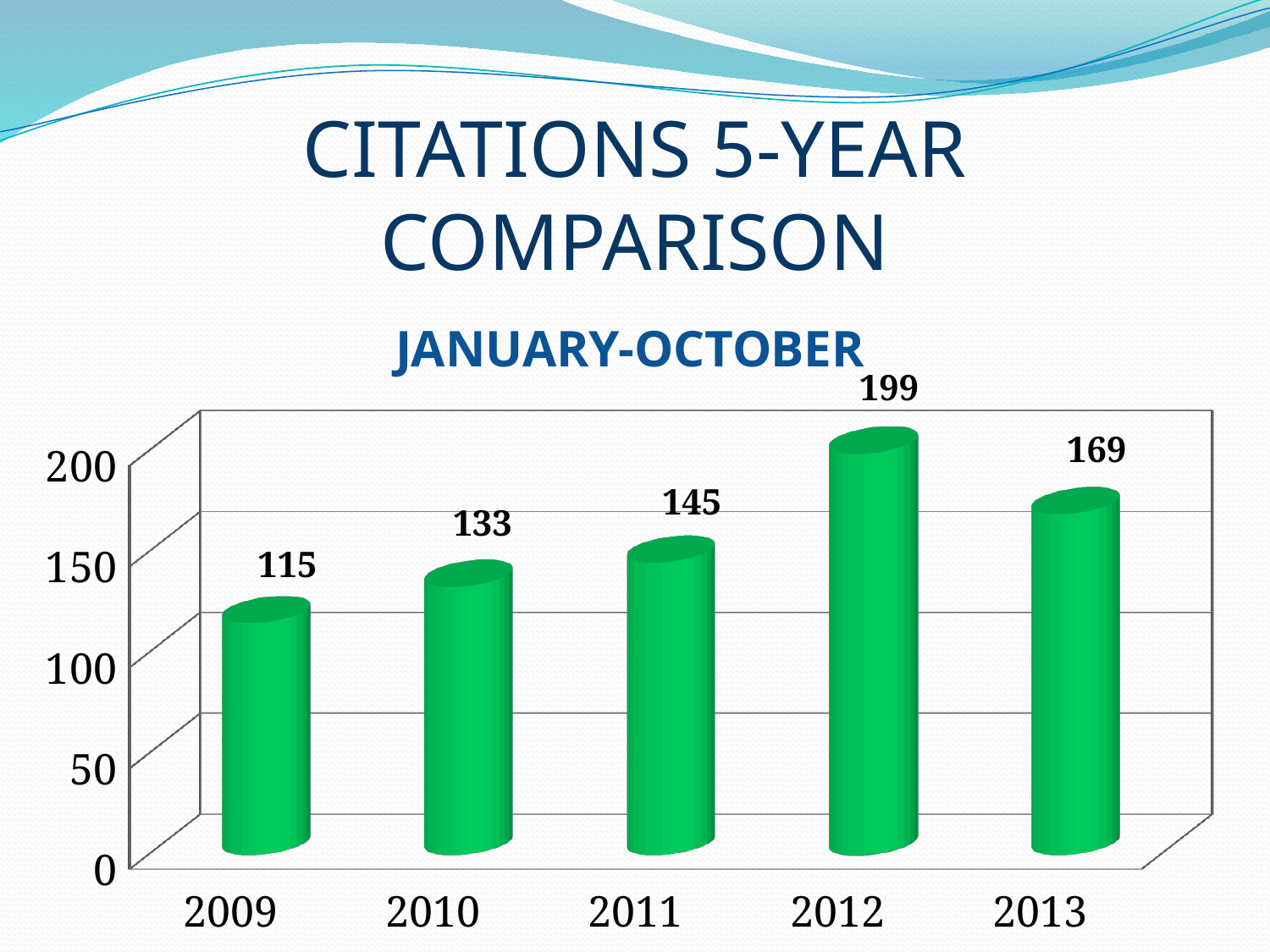
Is the value for 2011 greater or less than 150? less What is the chart's title? JANUARY-OCTOBER What is the difference between the values for 2012 and 2013? 30 Which year has the highest value? 2012 What is the value for 2009? 115 What is the difference between the values for 2011 and 2010? 12 Which is larger, the value for 2010 or the value for 2013? 2013 What is the value for 2012? 199 Which year has the lowest value? 2009 What is the value for 2013? 169 How many years are shown on the x axis? 5 What kind of chart is shown on the slide? bar chart